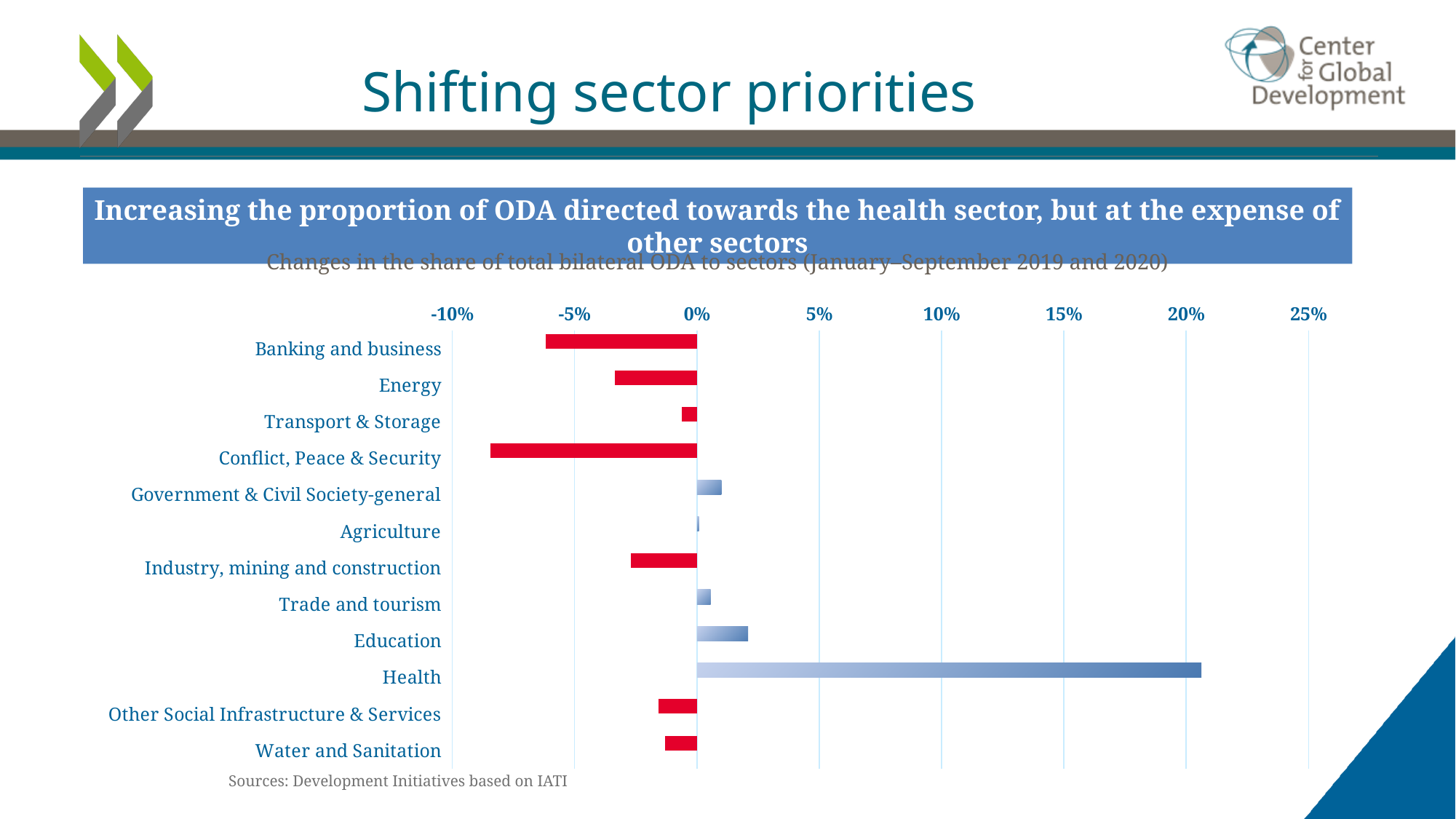
How many sectors are plotted in the chart? 12 Is the value for Health greater or less than 20%? greater Which sector has the lowest value in the chart? Conflict, Peace & Security Which has the larger value, Energy or Banking and business? Energy Is the value for Education greater or less than 5%? less What kind of chart is shown on the slide? bar chart Is the value for Banking and business greater or less than -5%? less What is the source cited below the chart? Development Initiatives based on IATI Which sector has the highest value in the chart? Health Which has the larger value, Education or Government & Civil Society-general? Education